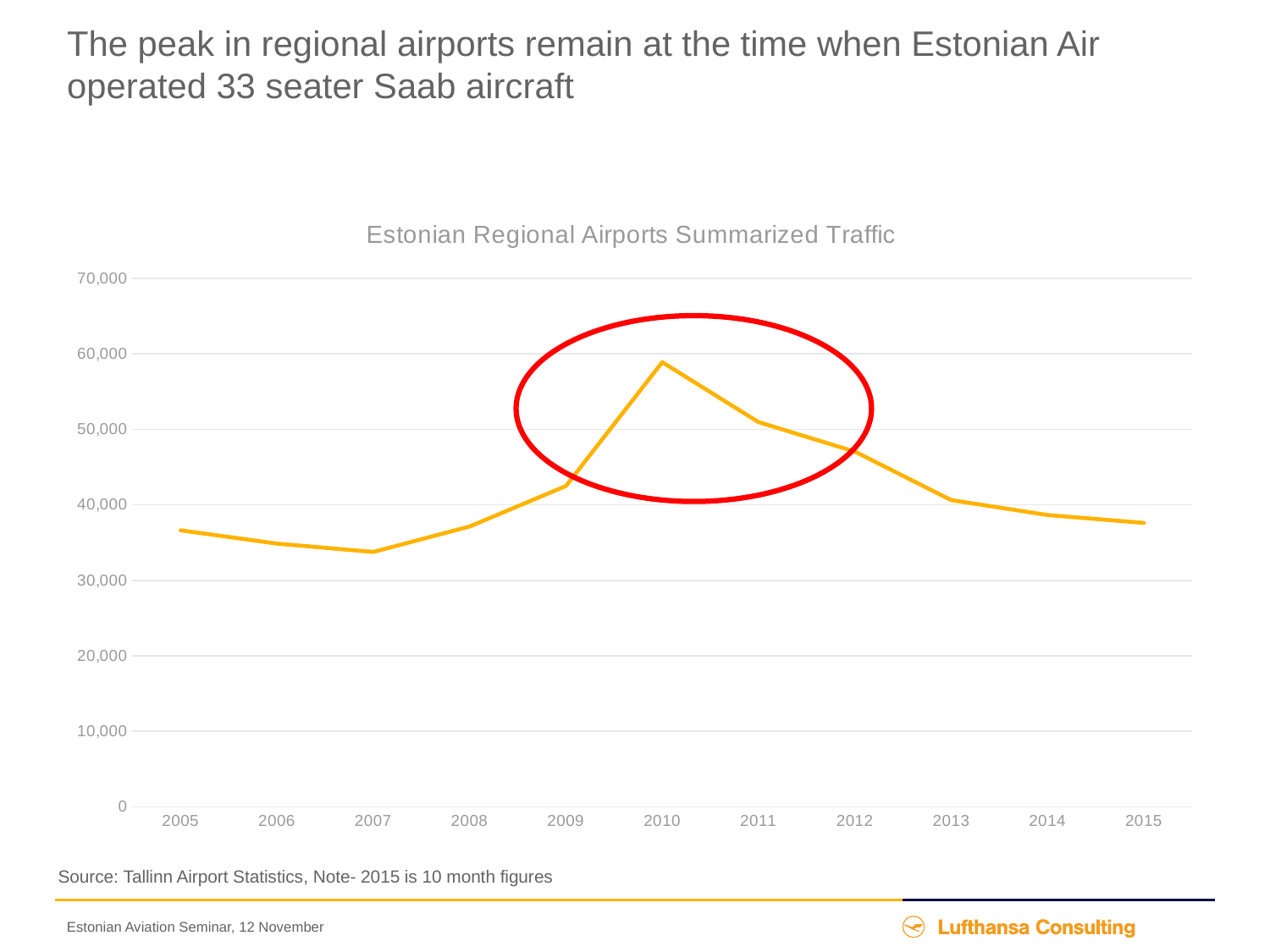
Which year has the lowest traffic value? 2007 What kind of chart is shown on the slide? line chart Which year has the larger value, 2009 or 2012? 2012 Is the value for 2007 greater or less than 40,000? less Which year on the chart is highlighted by the red circle? 2010 Which year has the highest traffic value? 2010 What is the title of the chart? Estonian Regional Airports Summarized Traffic How many years are plotted along the x axis? 11 Does the traffic rise or fall from 2010 to 2015? fall Is the value for 2010 greater or less than 50,000? greater Is the value for 2011 greater or less than 60,000? less